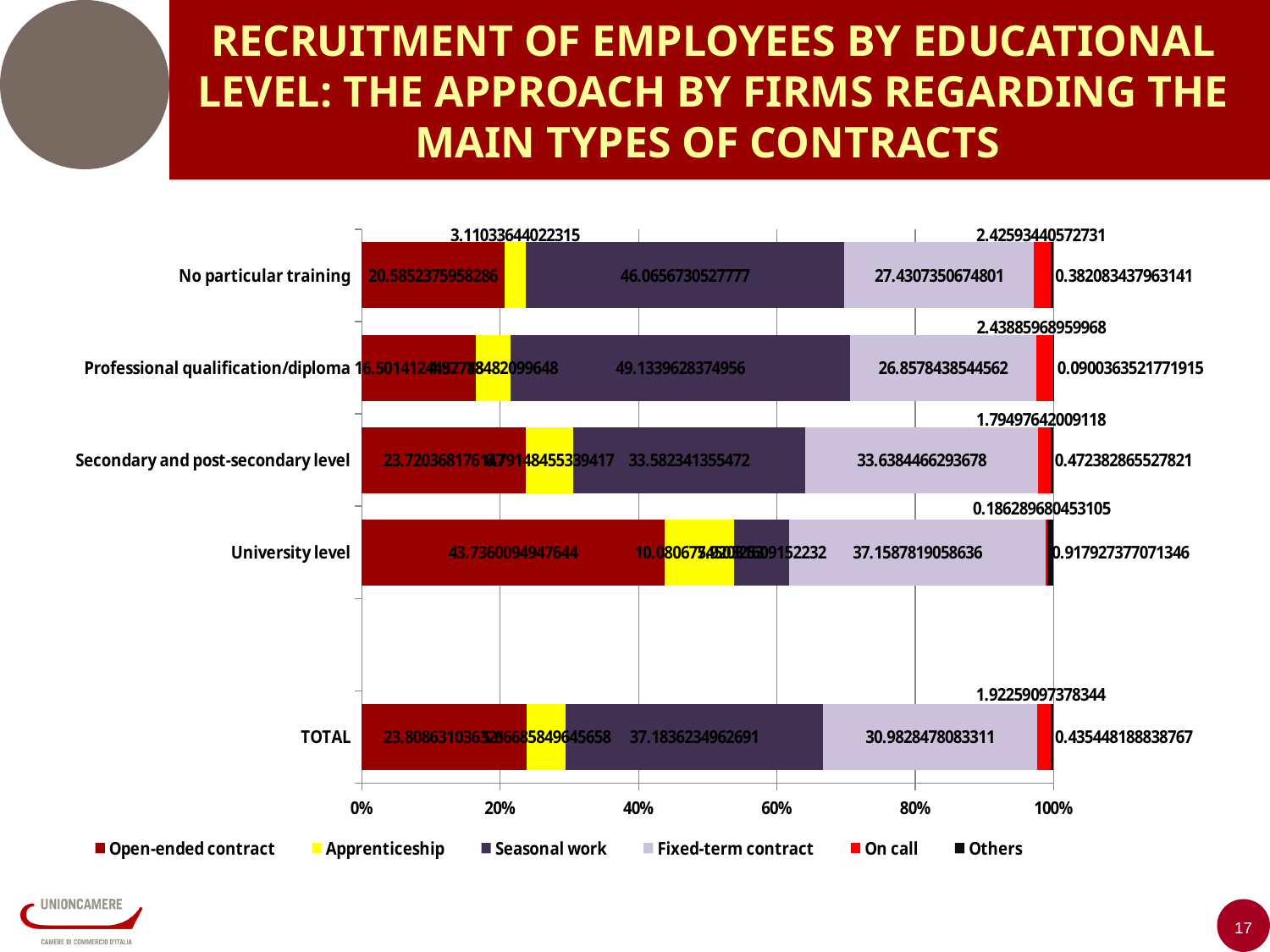
What is the Open-ended contract value for University level? 43.7360094947644 What is the Seasonal work value for TOTAL? 37.1836234962691 How many educational-level categories are plotted on the chart? 5 Which educational level has the highest Open-ended contract value? University level How many series does the legend list? 6 What is the Others value for Professional qualification/diploma? 0.0900363521771915 What is the Fixed-term contract value for University level? 37.1587819058636 Which series is shown in yellow in the legend? Apprenticeship Which educational level has the highest Seasonal work value? Professional qualification/diploma What is the Seasonal work value for No particular training? 46.0656730527777 Which is larger: the Fixed-term contract value for No particular training or for University level? University level What kind of chart is shown on the slide? Stacked bar chart